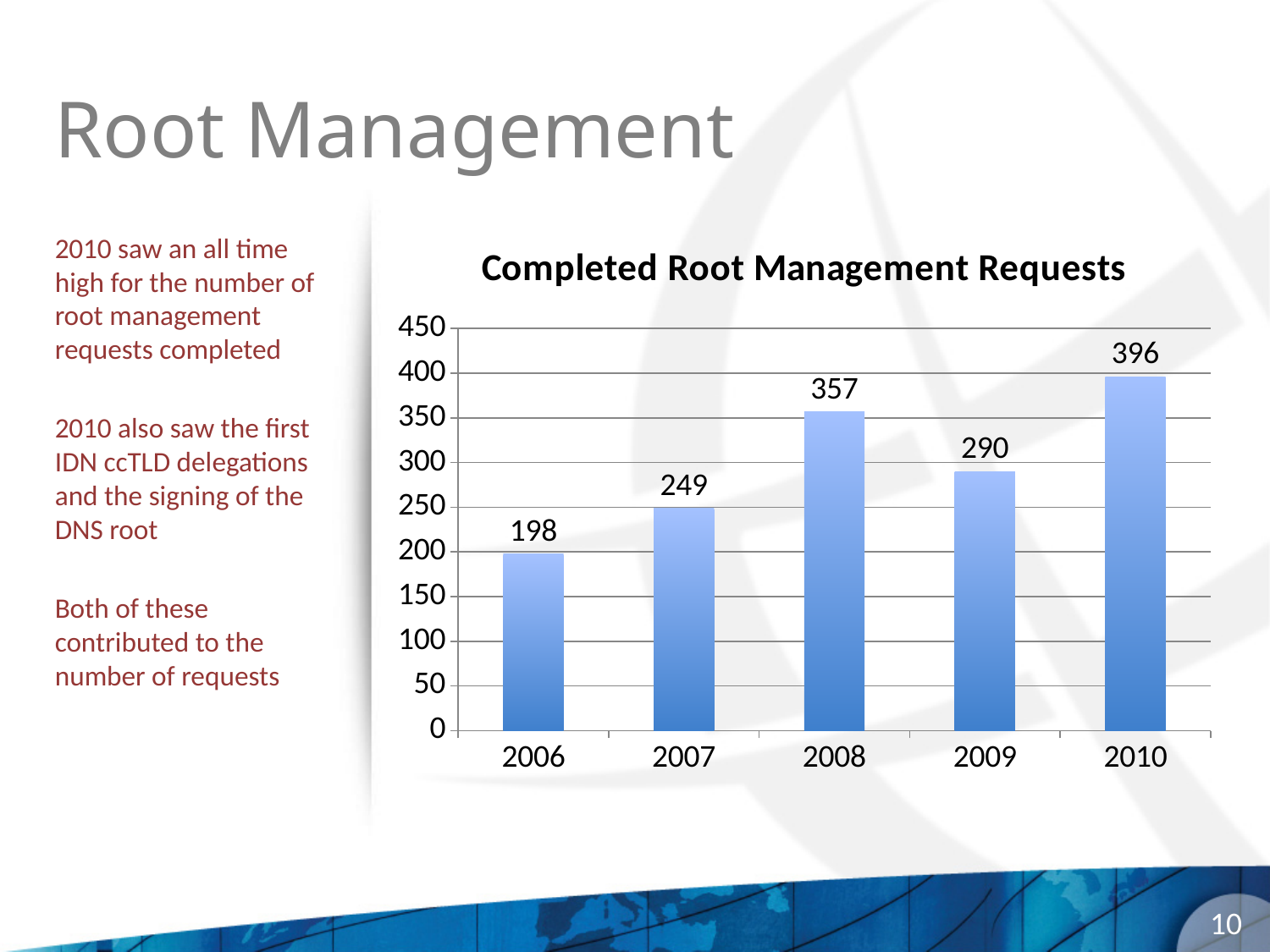
What is the difference between the values for 2010 and 2009? 106 What is the number of completed root management requests in 2008? 357 How much higher is the 2008 value than the 2007 value? 108 Which year has a larger value, 2008 or 2009? 2008 What kind of chart is used to show Completed Root Management Requests? bar chart Which year has the highest number of completed root management requests? 2010 How many years are shown on the x axis of the chart? 5 Is the value for 2007 greater or less than 300? less Did the number of completed requests rise or fall from 2008 to 2009? fall Which year has the lowest number of completed root management requests? 2006 What value is shown for 2006 in the Completed Root Management Requests chart? 198 What is the title of the chart on the slide? Completed Root Management Requests